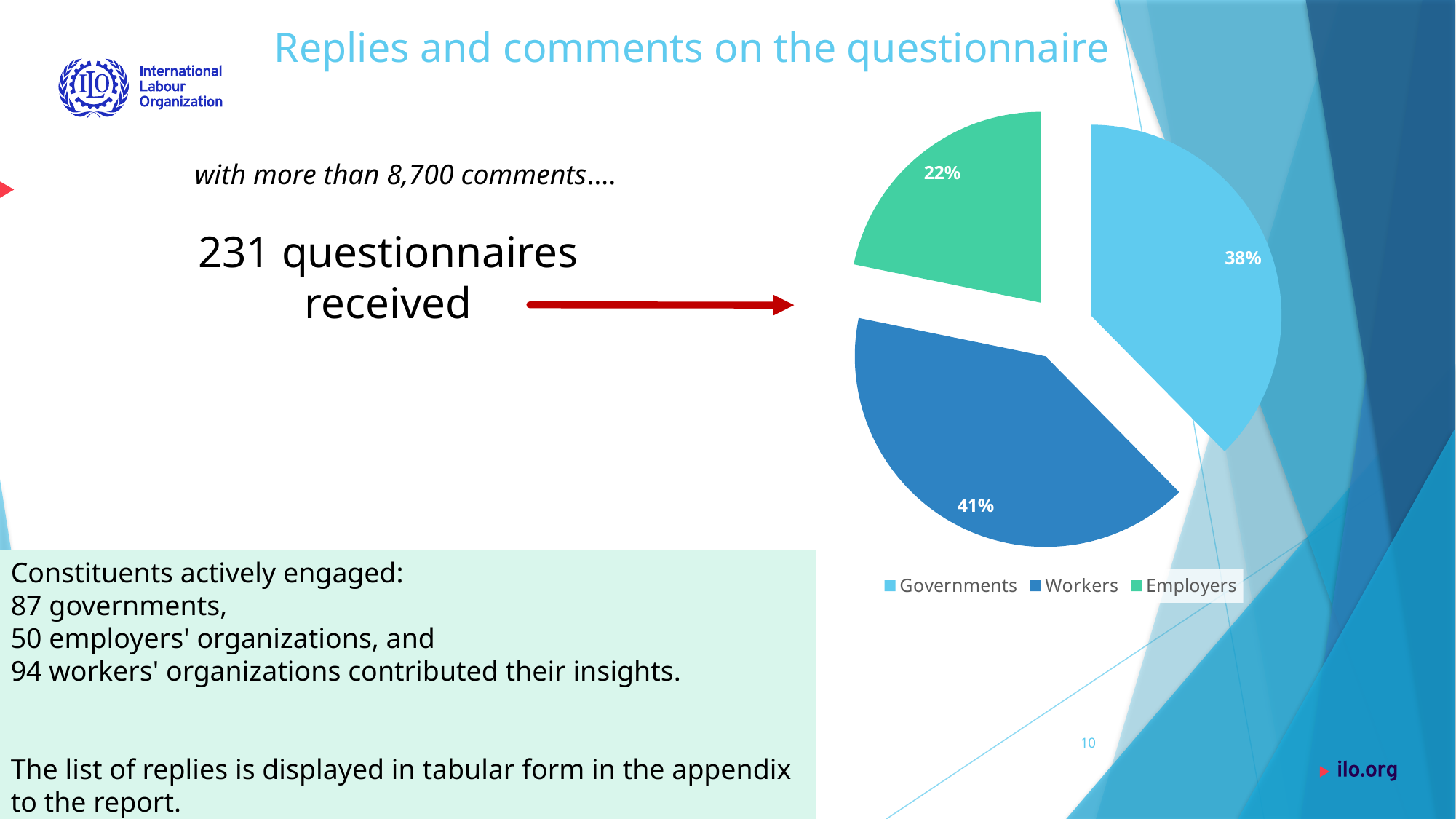
What share of the pie is labelled for Governments? 38% What is the difference in percentage points between the Governments slice and the Employers slice? 16 Which slice is larger, Governments or Employers? Governments What share of the pie is labelled for Workers? 41% Which category has the largest slice of the pie? Workers Which colour represents Employers in the pie chart? green What is the difference in percentage points between the Workers slice and the Employers slice? 19 Which category has the smallest slice of the pie? Employers What share of the pie is labelled for Employers? 22% How many slices does the pie chart have? 3 What kind of chart is shown on the slide? pie chart How many entries does the legend list? 3